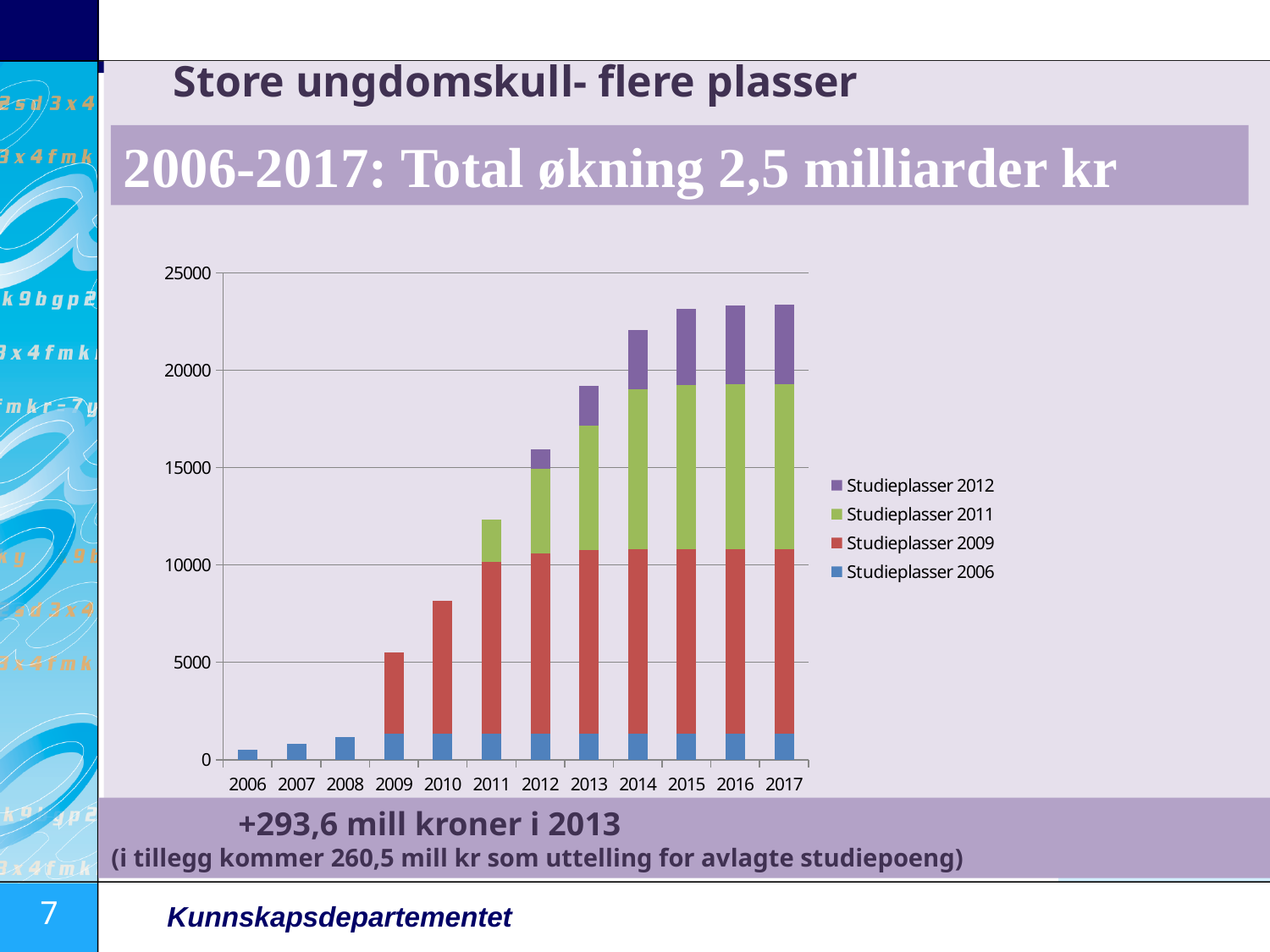
What kind of chart is shown on the slide? Stacked bar chart How many series does the chart's legend list? 4 Is the total value for 2010 greater or less than 10000? less Is the total value for 2011 greater or less than 10000? greater Is the total value for 2006 greater or less than 5000? less Do the total bar heights generally rise or fall from 2006 to 2017? Rise Which series is shown at the bottom of each stacked bar? Studieplasser 2006 Which year has the larger total bar, 2010 or 2011? 2011 How many years are shown along the x axis of the chart? 12 Which year has the lowest total bar in the chart? 2006